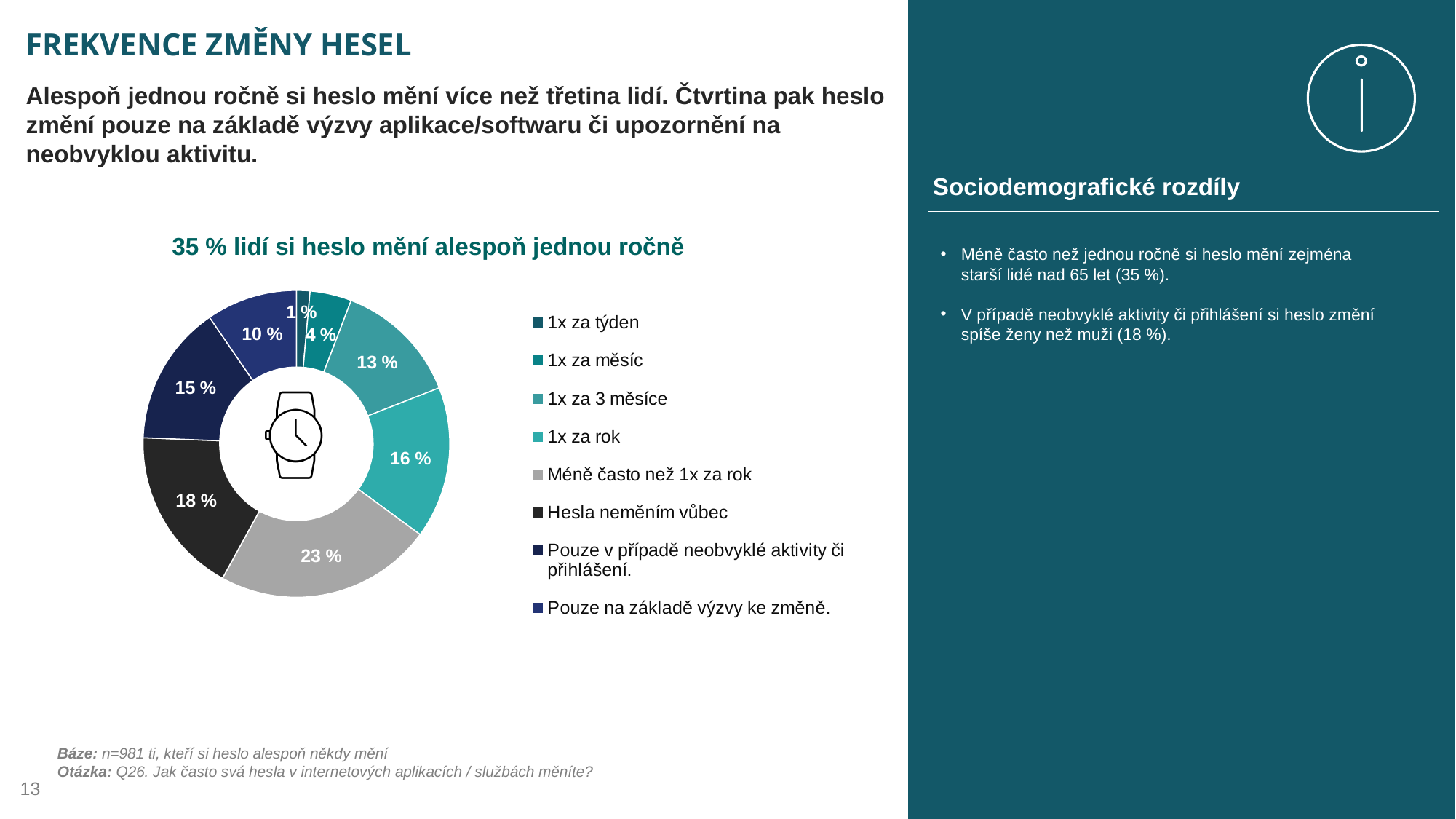
Which category has the largest share of the pie? Méně často než 1x za rok What is the combined share of "1x za týden" and "1x za měsíc"? 5 % What is the value for "1x za rok"? 16 % Which is larger: the value for "1x za 3 měsíce" or the value for "Pouze v případě neobvyklé aktivity či přihlášení."? Pouze v případě neobvyklé aktivity či přihlášení. What is the value for "Hesla neměním vůbec"? 18 % What is the title of the chart? 35 % lidí si heslo mění alespoň jednou ročně What kind of chart is shown on the slide? Pie (donut) chart What is the value for "Méně často než 1x za rok"? 23 % How many categories does the pie chart show? 8 What is the difference between the values for "Méně často než 1x za rok" and "Hesla neměním vůbec"? 5 % What is the value for "Pouze na základě výzvy ke změně."? 10 % Which category has the smallest share of the pie? 1x za týden